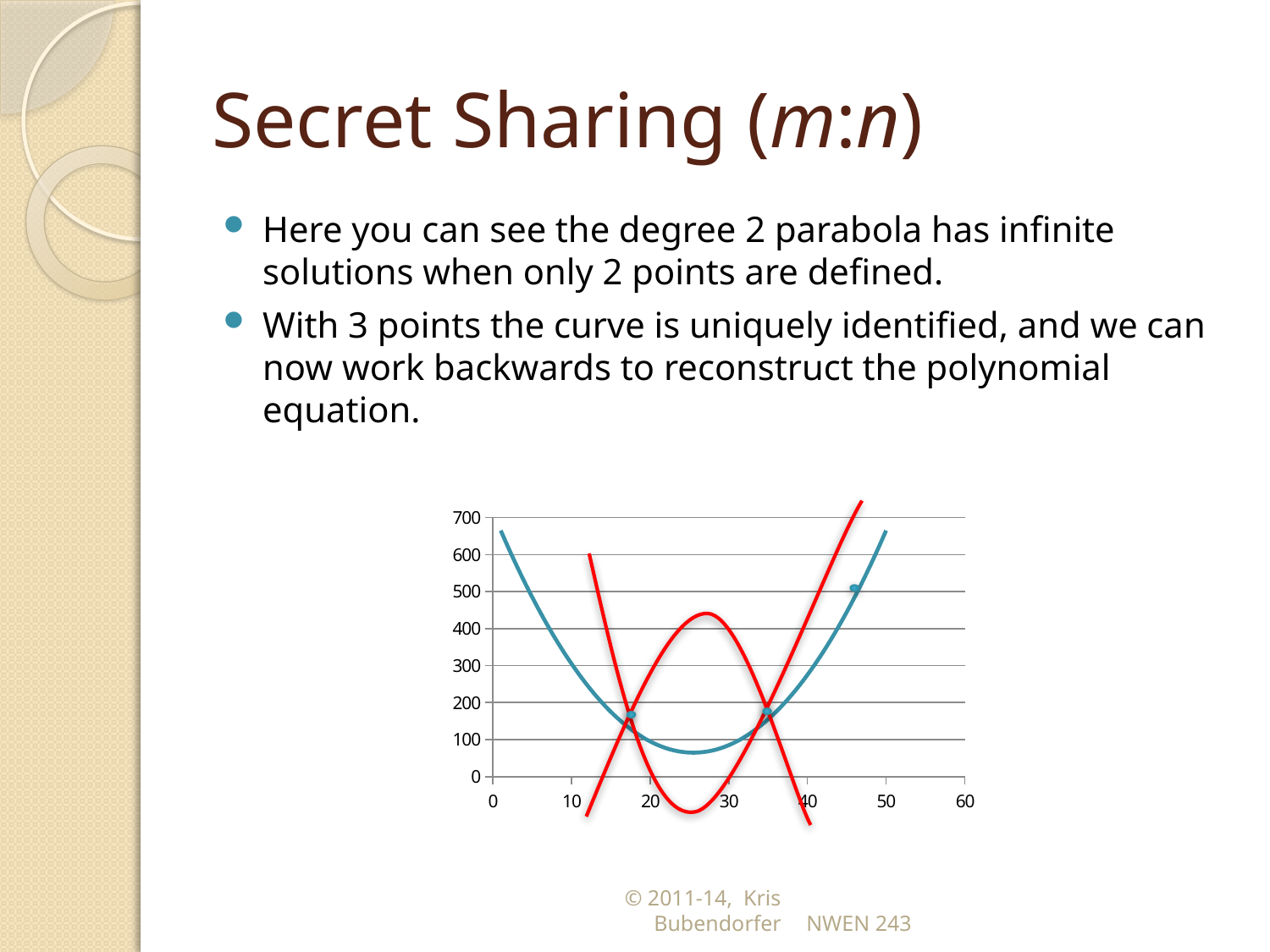
Is the value of the marked point near x = 46 greater or less than 400? greater Is the lowest point of the blue curve greater or less than 100? less Is the value of the marked point near x = 17 greater or less than 200? less Does the blue curve rise or fall as x increases from 0 to 20? fall Which of the marked points has the larger value: the one near x = 17 or the one near x = 46? the one near x = 46 What is the highest value labelled on the vertical axis? 700 Does the blue curve rise or fall as x increases from 30 to 50? rise How many marked data points are shown on the blue curve? 3 What kind of chart is shown on the slide? line chart What is the highest value labelled on the horizontal axis? 60